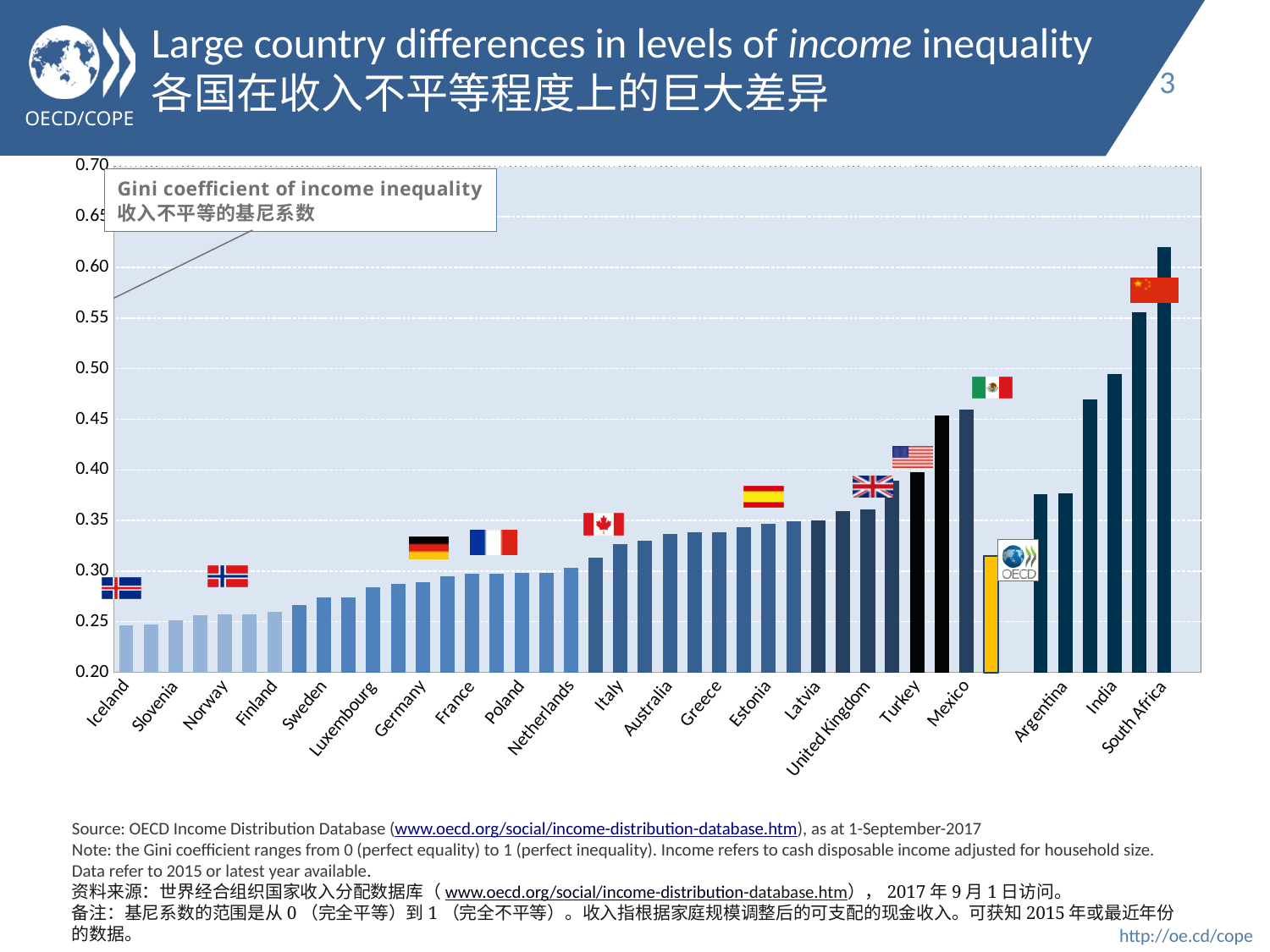
Is the Gini coefficient for Iceland greater or less than 0.30? less Which has a higher Gini coefficient, India or Norway? India Is the Gini coefficient for the United Kingdom greater or less than 0.40? less Which country has the highest Gini coefficient in the chart? South Africa Is the Gini coefficient for South Africa greater or less than 0.55? greater Which country has the lowest Gini coefficient in the chart? Iceland What kind of chart is shown on the slide? bar chart What is the English title shown in the chart's title box? Gini coefficient of income inequality Do the Gini coefficient values rise or fall from left to right across the countries? rise